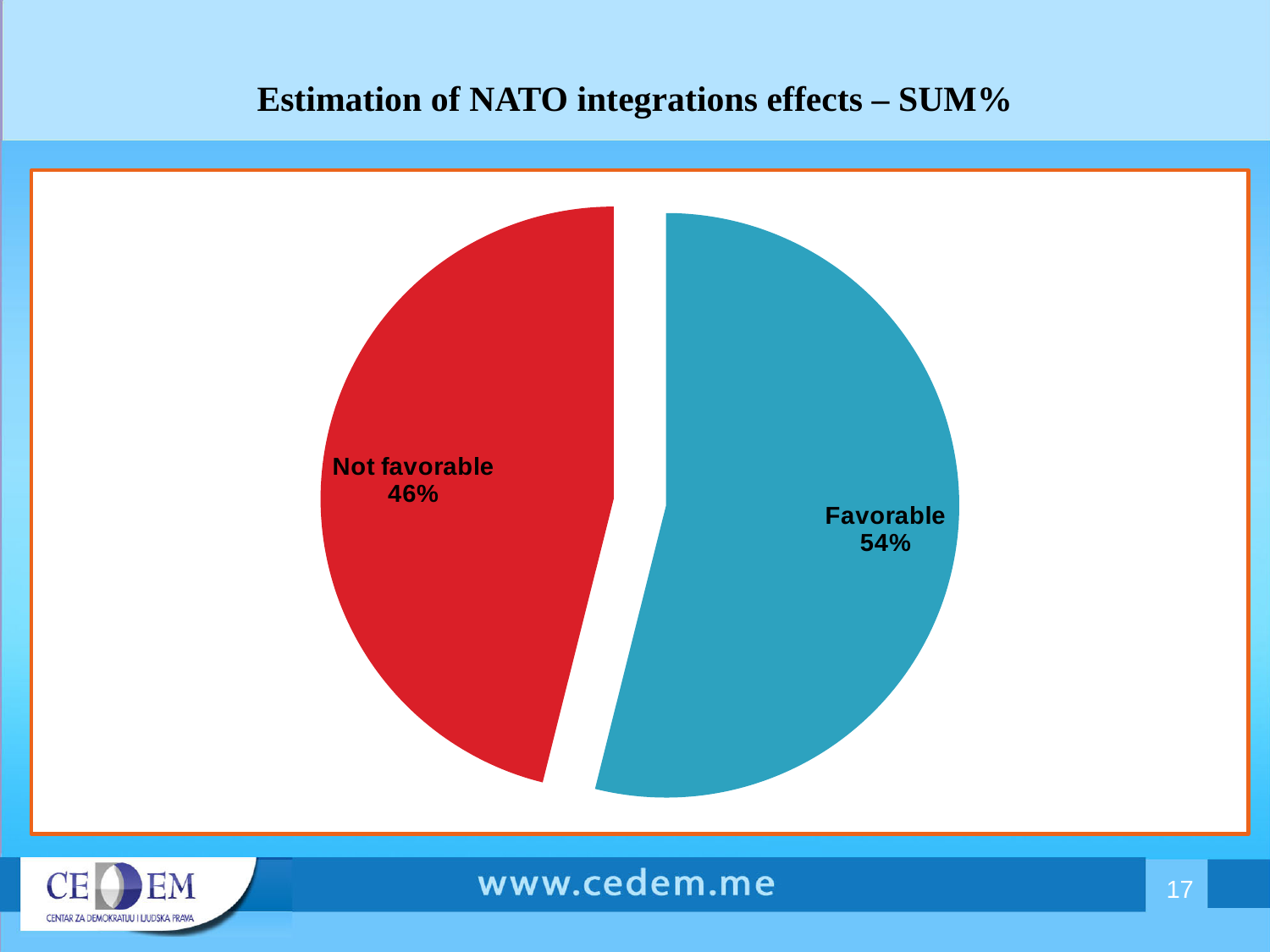
What colour is the Favorable slice of the pie? Blue Which slice of the pie is the largest? Favorable How many slices does the pie chart have? 2 What kind of chart is shown on the slide? Pie chart What share of the pie does the Not favorable slice represent? 46% Which slice of the pie is the smallest? Not favorable What percentage of the pie is labelled Favorable? 54% What is the title of the chart on the slide? Estimation of NATO integrations effects – SUM% What percentage of the pie is labelled Not favorable? 46% What is the difference in percentage points between the Favorable and Not favorable slices? 8 Which is larger, the Favorable slice or the Not favorable slice? Favorable